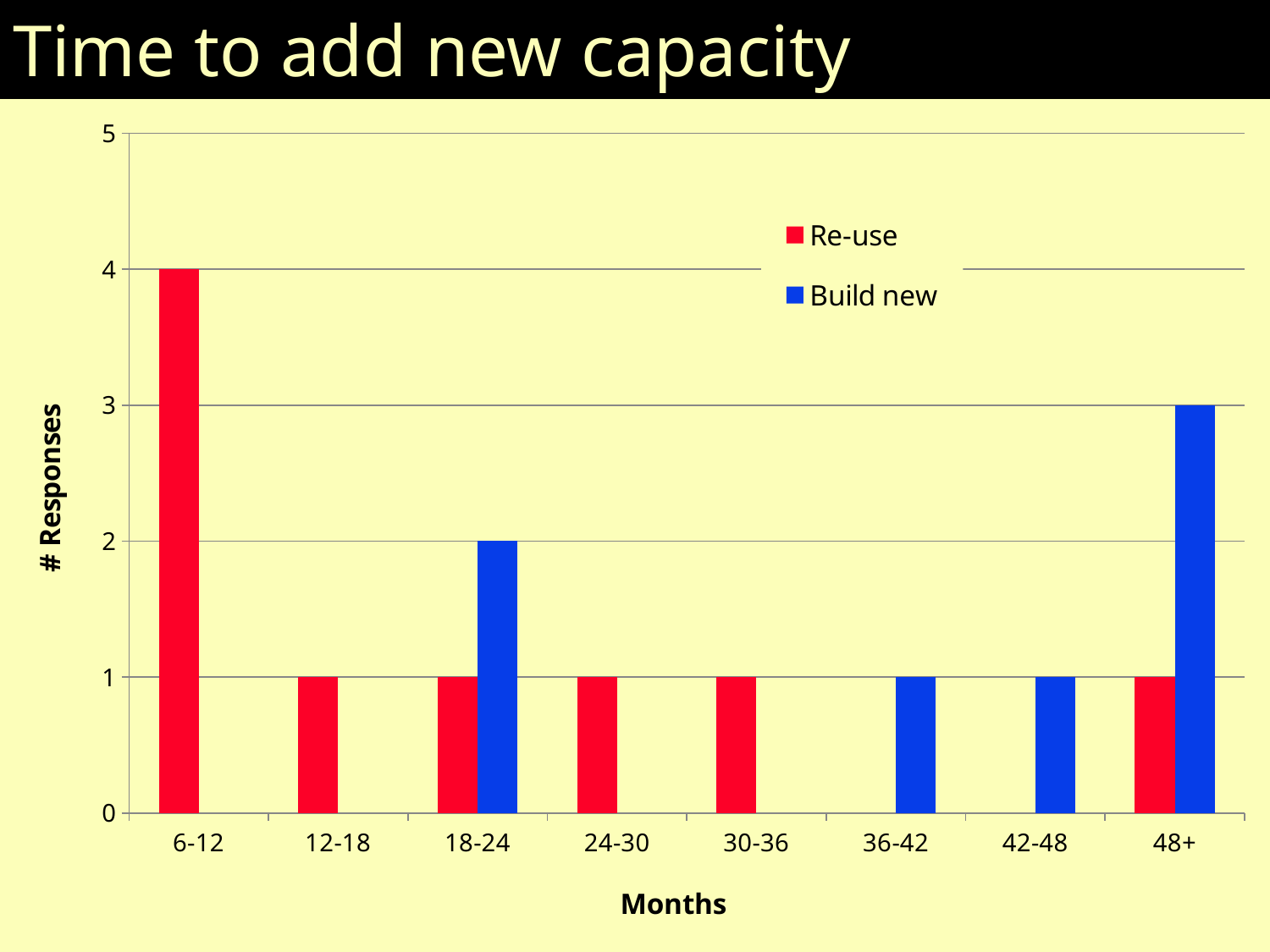
Which month category has the highest number of Build new responses? 48+ Which month category has the highest number of Re-use responses? 6-12 What is the number of Build new responses for 48+ months? 3 What is the difference between Re-use responses for 6-12 months and Build new responses for 48+ months? 1 How many series does the legend list? 2 What is the number of Build new responses for 18-24 months? 2 For 18-24 months, which series has more responses, Re-use or Build new? Build new What type of chart is shown on the slide? Bar chart What is the number of Re-use responses for 6-12 months? 4 What is the title of the chart? Time to add new capacity Is the value for Re-use at 6-12 months greater or less than 3? greater How many month categories are shown on the x axis? 8